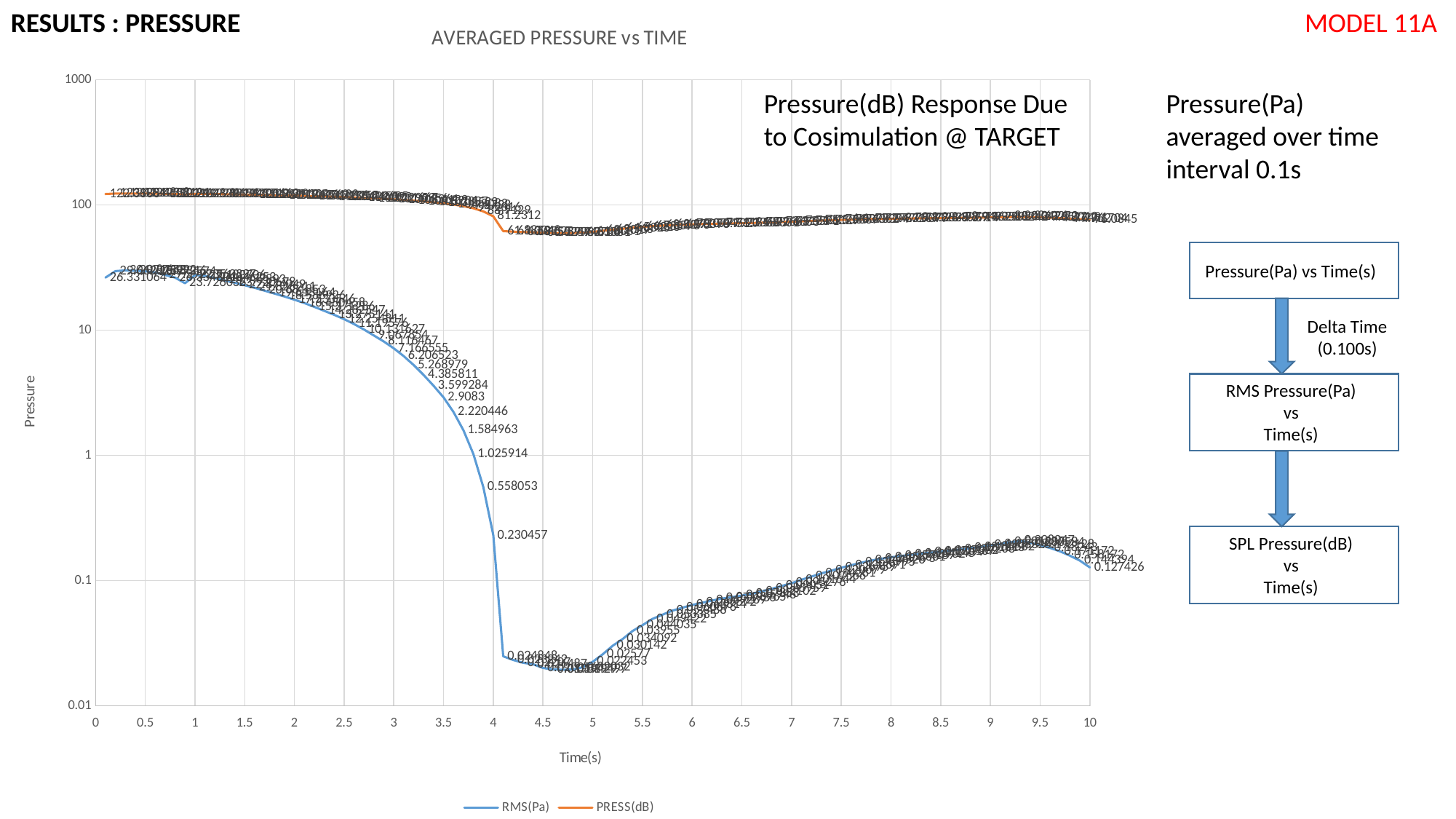
What are the two series named in the chart legend? RMS(Pa) and PRESS(dB) Is the value of RMS(Pa) at Time = 4.5 s greater or less than 0.1? less What is the first labelled value of the RMS(Pa) series at the left end of the chart? 26.331064 Is the value of PRESS(dB) at Time = 5 s greater or less than 100? less Is the value of RMS(Pa) at Time = 1 s greater or less than 10? greater How many series does the legend of the chart list? 2 What is the last labelled value of the RMS(Pa) series at the right end of the chart (Time = 10 s)? 0.127426 What is the title of the chart? AVERAGED PRESSURE vs TIME At Time = 3 s, which series has the higher value, RMS(Pa) or PRESS(dB)? PRESS(dB) What type of chart is shown on the slide? line chart Does the RMS(Pa) series rise or fall between Time = 0 s and Time = 4 s? fall